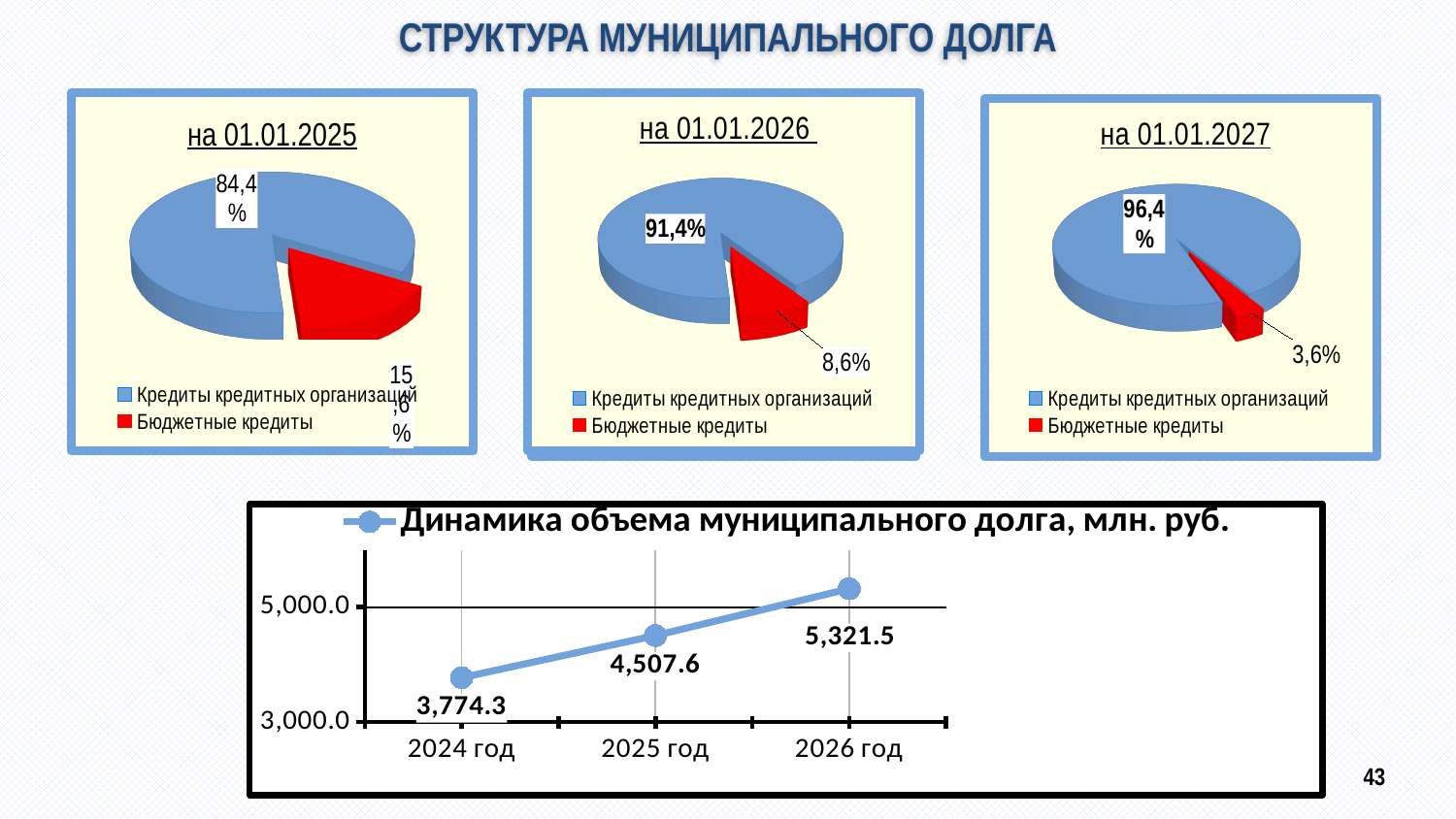
In the pie chart 'на 01.01.2026', what share is shown for Кредиты кредитных организаций? 91,4% How many series does the legend of the pie chart 'на 01.01.2026' list? 2 In the chart 'Динамика объема муниципального долга, млн. руб.', do the values rise or fall from 2024 год to 2026 год? rise In the chart 'Динамика объема муниципального долга, млн. руб.', which year has the highest value? 2026 год In the chart 'Динамика объема муниципального долга, млн. руб.', what is the value for 2025 год? 4,507.6 In the pie chart 'на 01.01.2027', which category has the smallest share? Бюджетные кредиты In the pie chart 'на 01.01.2025', which category has the largest share? Кредиты кредитных организаций In the chart 'Динамика объема муниципального долга, млн. руб.', what is the difference between the values for 2026 год and 2024 год? 1,547.2 In the pie chart 'на 01.01.2027', what share is shown for Бюджетные кредиты? 3,6% In the pie chart 'на 01.01.2025', what share is shown for Бюджетные кредиты? 15,6% What kind of chart is 'Динамика объема муниципального долга, млн. руб.'? line chart In the chart 'Динамика объема муниципального долга, млн. руб.', how many data points are plotted? 3